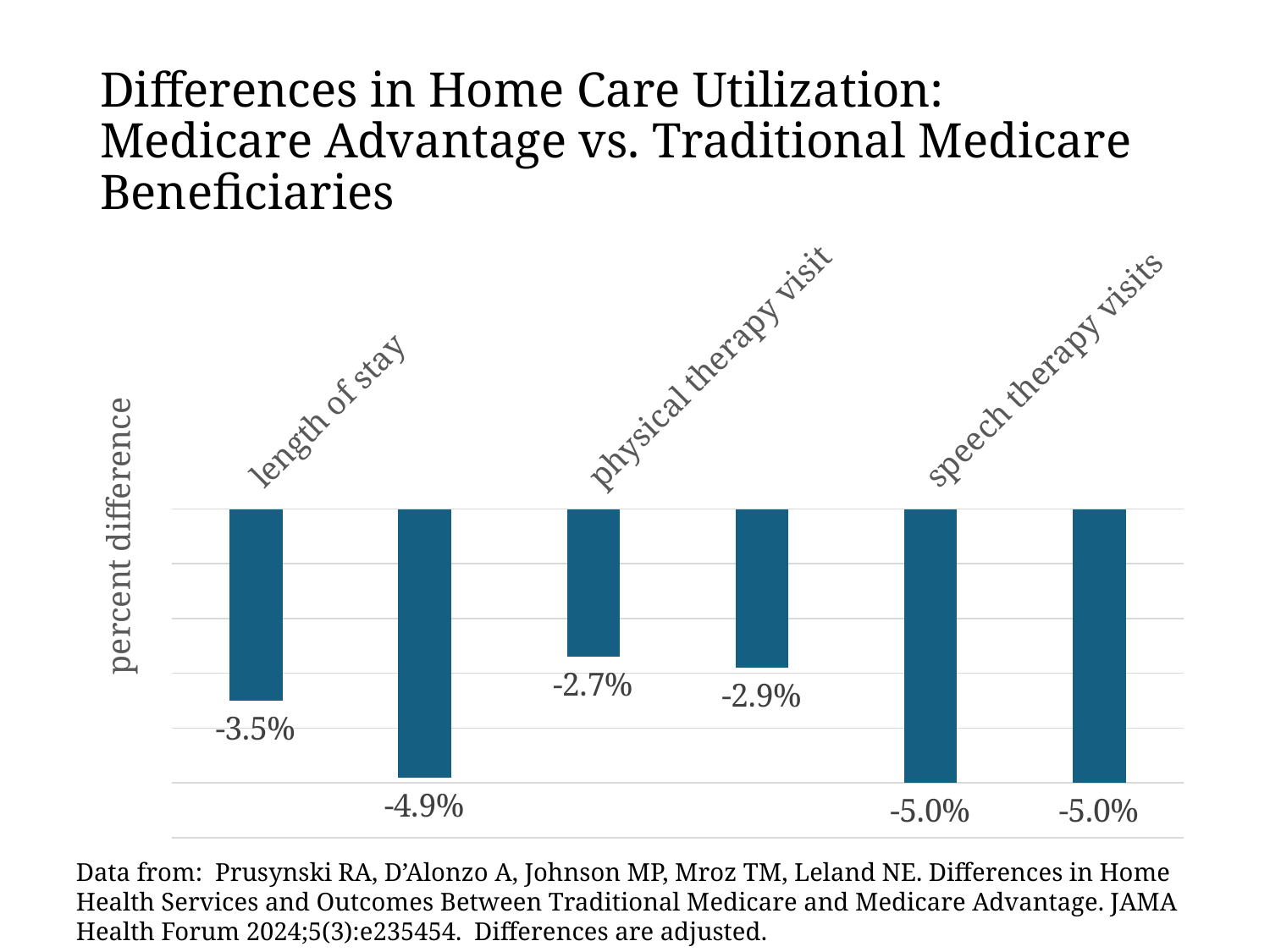
Which bar extends further below zero: the second length of stay bar or the second physical therapy visit bar? the second length of stay bar (-4.9%) What is the difference in percentage points between the two length of stay bars (-3.5% and -4.9%)? 1.4 percentage points What value is shown for both bars under speech therapy visits? -5.0% Which category shows the largest negative percent difference? speech therapy visits How many categories are shown on the x axis? 3 Which single bar has the smallest negative percent difference? -2.7% (physical therapy visit) What type of chart is shown on the slide? bar chart What is the value of the first bar for length of stay? -3.5% What is the value of the second bar for physical therapy visit? -2.9% What is the label on the vertical axis? percent difference What is the value of the second bar for length of stay? -4.9% What is the value of the first bar for physical therapy visit? -2.7%